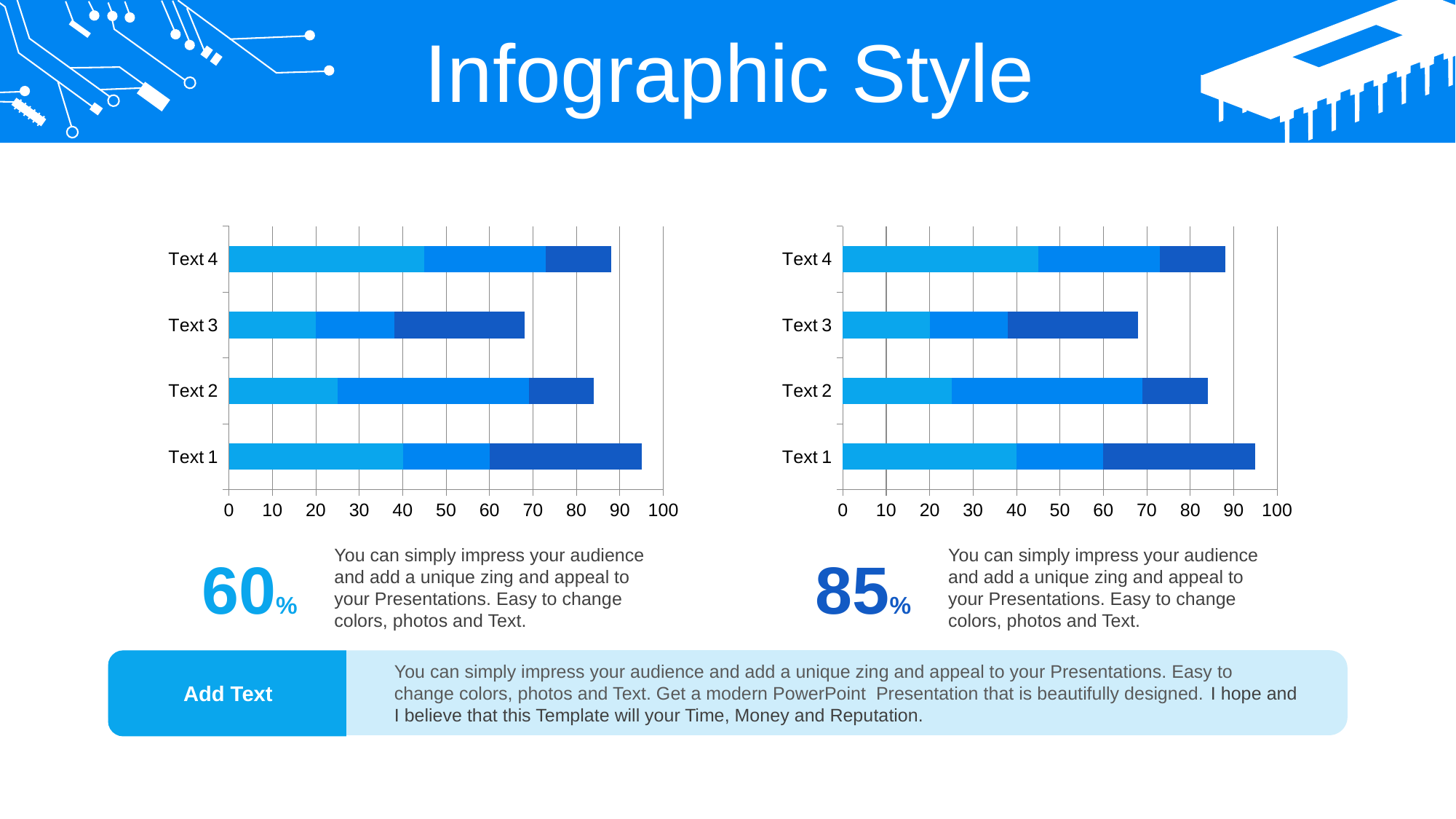
On the right chart, which has the longer total bar, Text 4 or Text 3? Text 4 On the left chart, which category has the shortest total bar? Text 3 On the left chart, which category has the longest total bar? Text 1 On the right chart, how many categories are plotted? 4 On the right chart, is the total bar for Text 2 greater or less than 80? greater On the left chart, how many categories are plotted? 4 On the left chart, what kind of chart is shown? bar chart On the left chart, is the total bar for Text 3 greater or less than 70? less On the right chart, which has the longer total bar, Text 1 or Text 3? Text 1 On the right chart, is the total bar for Text 4 greater or less than 80? greater On the right chart, what is the highest value shown on the horizontal axis? 100